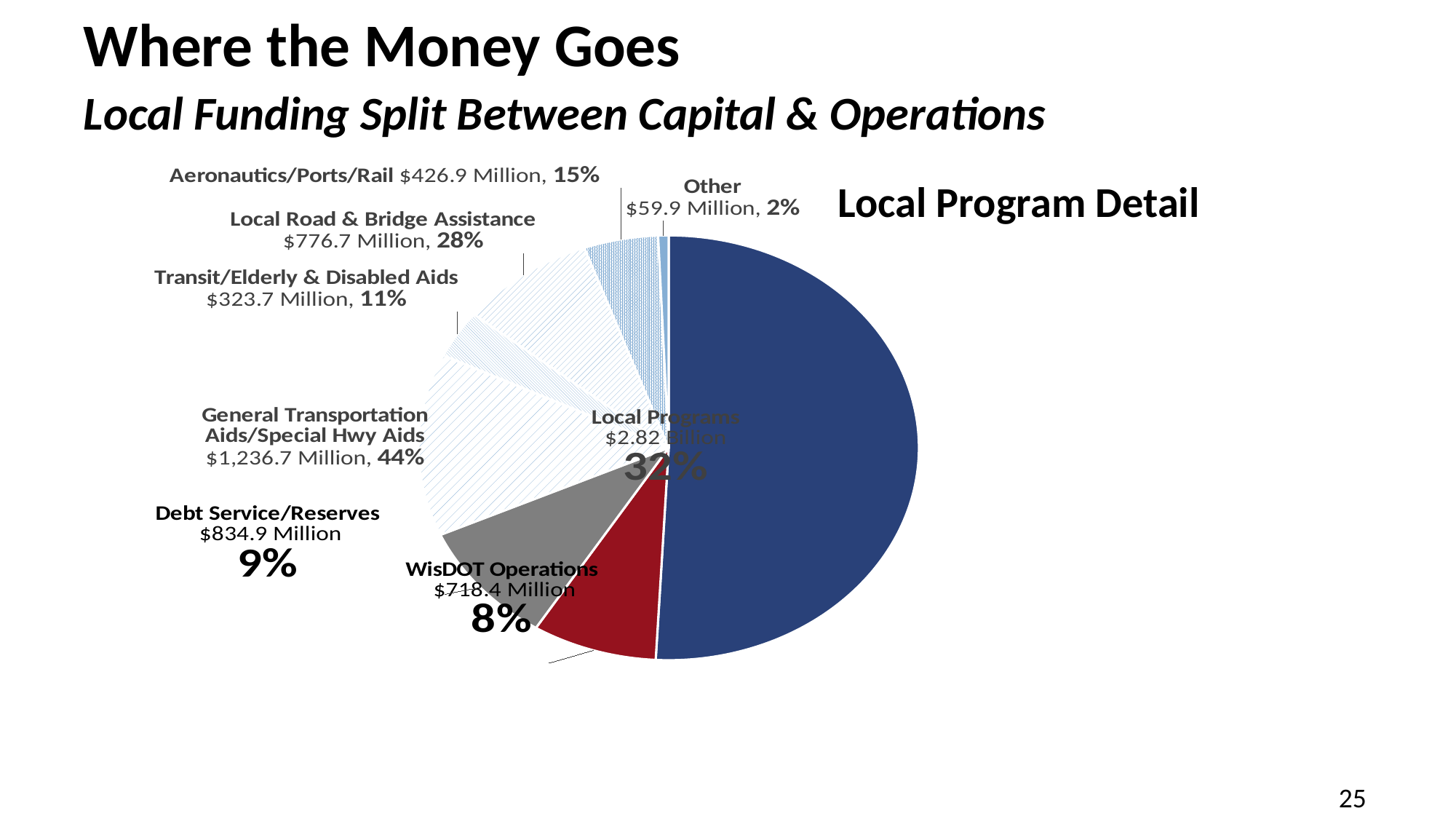
What is the difference in percentage points between General Transportation Aids/Special Hwy Aids and Local Road & Bridge Assistance? 16% What percentage is shown for Transit/Elderly & Disabled Aids? 11% Which Local Program Detail category has the largest share? General Transportation Aids/Special Hwy Aids How many Local Program Detail categories are labeled on the chart? 5 What kind of chart is shown on the slide? Pie chart Which is larger, the dollar amount for Debt Service/Reserves or for WisDOT Operations? Debt Service/Reserves What percentage is shown for General Transportation Aids/Special Hwy Aids? 44% What is the dollar amount shown for Local Road & Bridge Assistance? $776.7 Million What is the dollar amount shown for Local Programs? $2.82 Billion What is the dollar amount shown for Aeronautics/Ports/Rail? $426.9 Million What percentage is shown for WisDOT Operations? 8% Which Local Program Detail category has the smallest share? Other